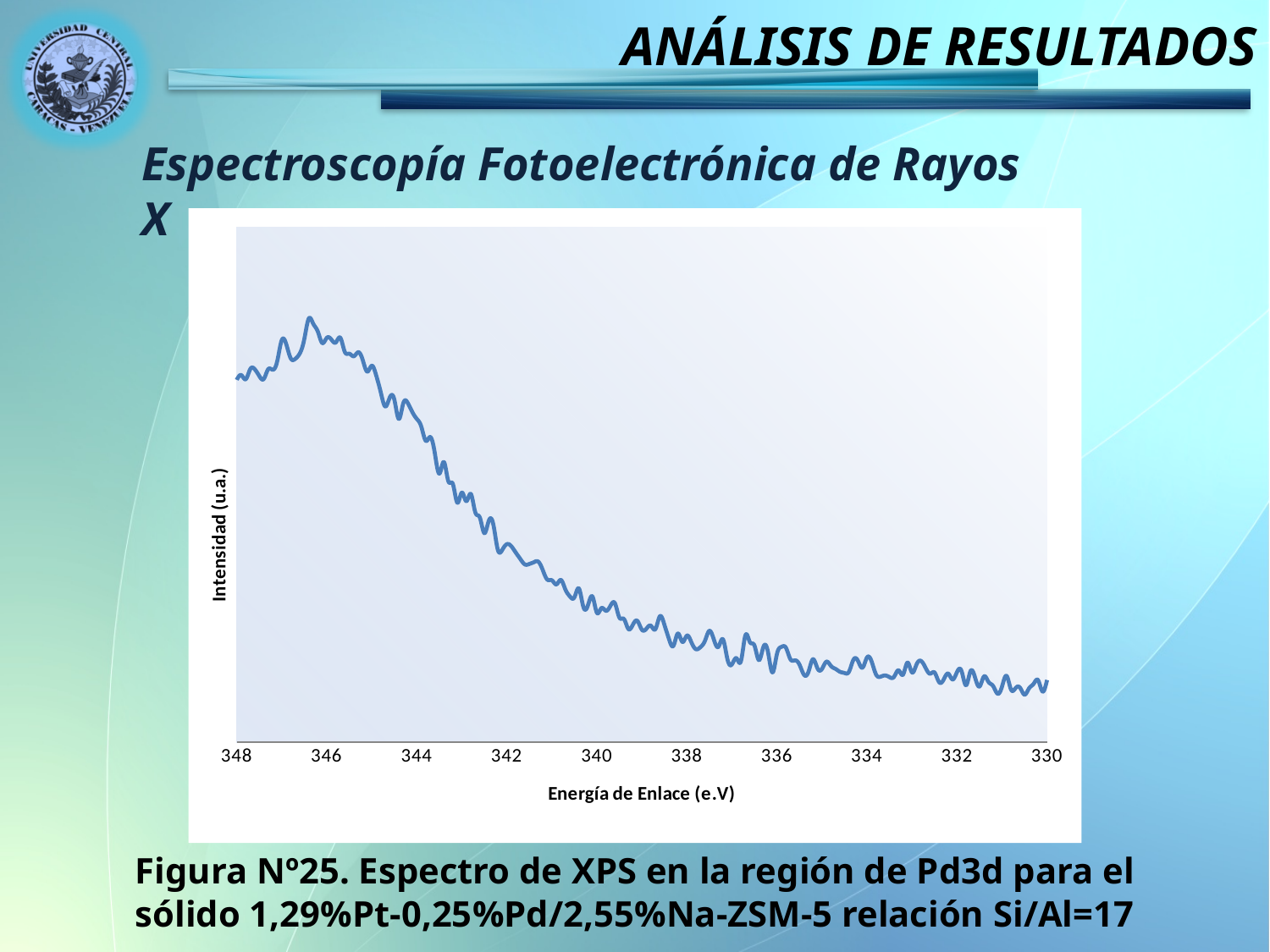
How many tick labels are shown on the x axis? 10 Is the intensity higher at a binding energy of 346 or at 334? 346 Is the intensity higher at a binding energy of 348 or at 332? 348 What is the label of the x axis of the chart? Energía de Enlace (e.V) Does the intensity rise or fall moving from left to right along the x axis? fall What is the leftmost value shown on the x axis? 348 What kind of chart is shown on the slide? line chart What is the label of the y axis of the chart? Intensidad (u.a.) Near which labelled x-axis value does the curve reach its lowest intensity? 330 Is the intensity higher at a binding energy of 344 or at 338? 344 Near which labelled x-axis value does the curve reach its highest intensity? 346